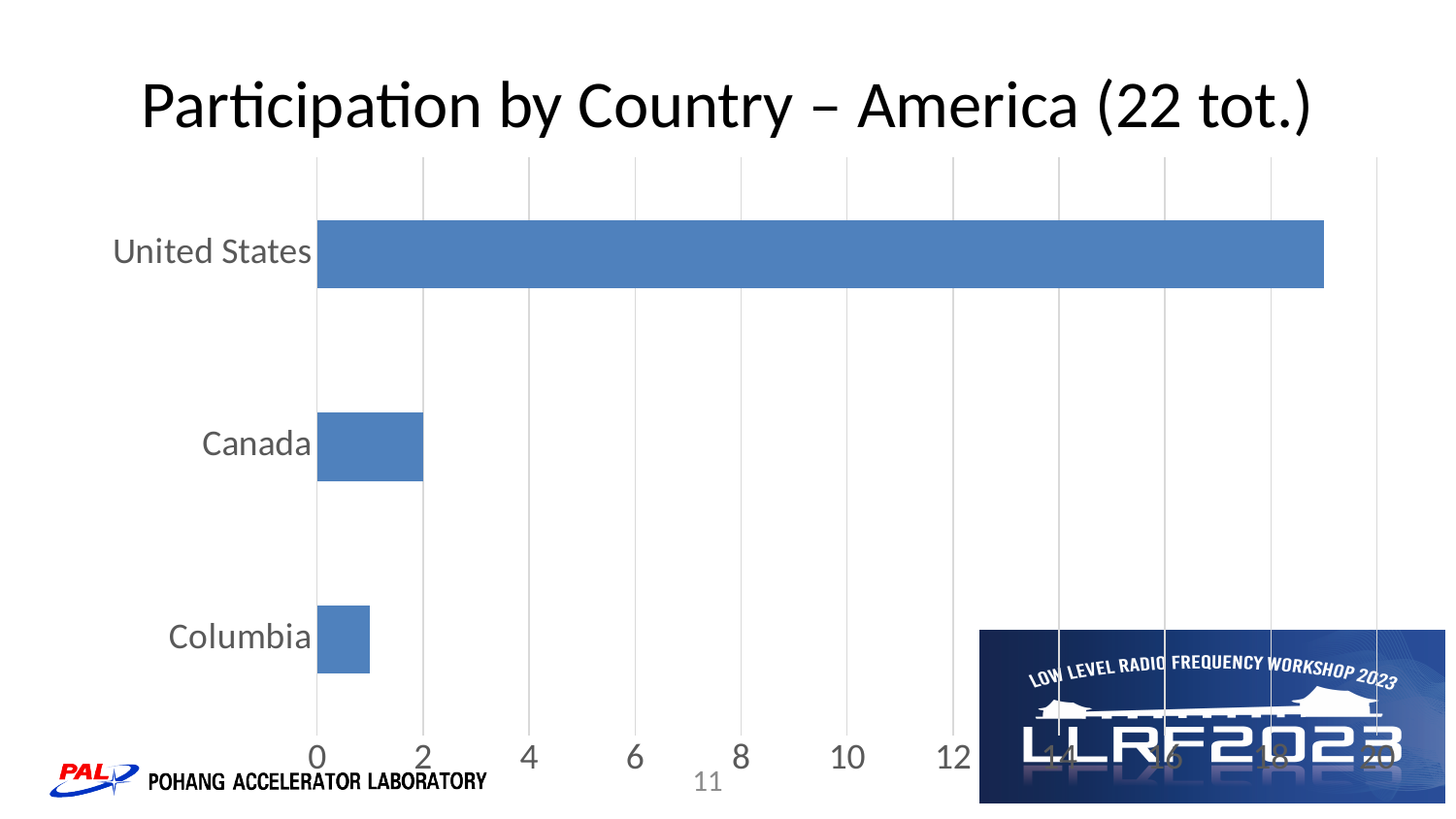
Which country has the lowest participation? Columbia Is the value for the United States greater or less than 20? less Which has a larger value, Canada or Columbia? Canada What is the title of the chart? Participation by Country – America (22 tot.) Is the value for the United States greater or less than 18? greater How many countries are shown in the chart? 3 What is the maximum value shown on the horizontal axis? 20 Which has a larger value, United States or Canada? United States Is the value for Columbia greater or less than 2? less What is the participation value for Canada? 2 What kind of chart is shown on the slide? bar chart Which country has the highest participation? United States